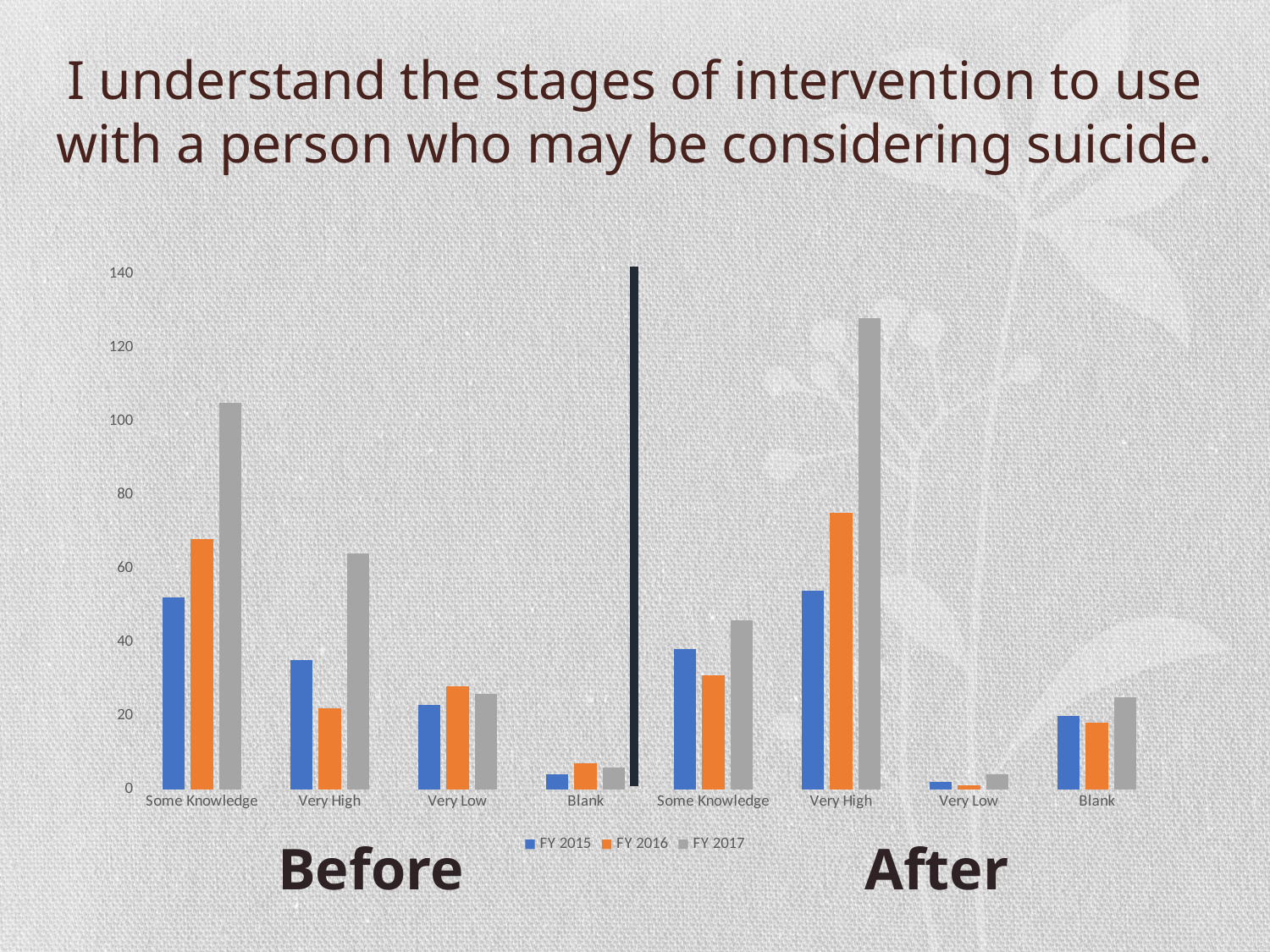
What kind of chart is shown on the slide? Bar chart Is the FY 2015 value for Very High in the Before section greater or less than 40? less What two labels appear below the chart to mark its left and right halves? Before and After Which category has the tallest FY 2017 bar? Very High (After) Is the FY 2017 value for Some Knowledge in the Before section greater or less than 100? greater Is the FY 2016 value for Very High in the After section greater or less than 60? greater For Very Low in the After section, which series has the lowest bar? FY 2016 For Some Knowledge in the Before section, which is larger: FY 2015 or FY 2016? FY 2016 What are the three entries in the chart legend? FY 2015, FY 2016, FY 2017 How many categories are shown along the x axis? 8 How many series does the legend list? 3